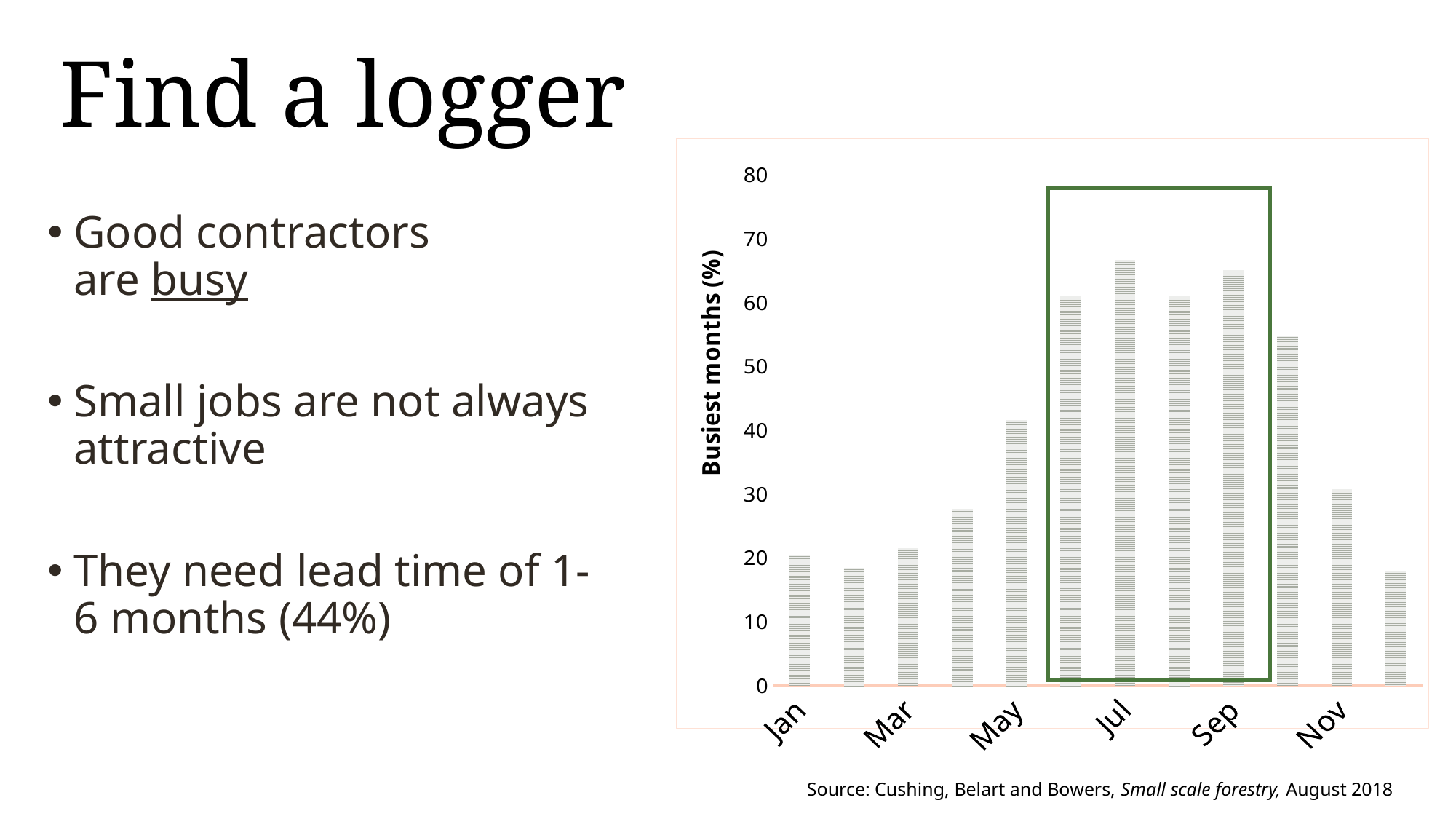
Do the values rise or fall from Jan to Jul? rise What is the highest value shown on the vertical axis of the chart? 80 Which month has the larger value, Jul or Jan? Jul Is the value for Jul greater or less than 60? greater Is the value for Nov greater or less than 20? greater Is the value for Sep greater or less than 50? greater What is the title of the vertical axis of the chart? Busiest months (%) What kind of chart is shown on the slide? bar chart Which month has the larger value, May or Nov? May How many bars (months) are plotted in the chart? 12